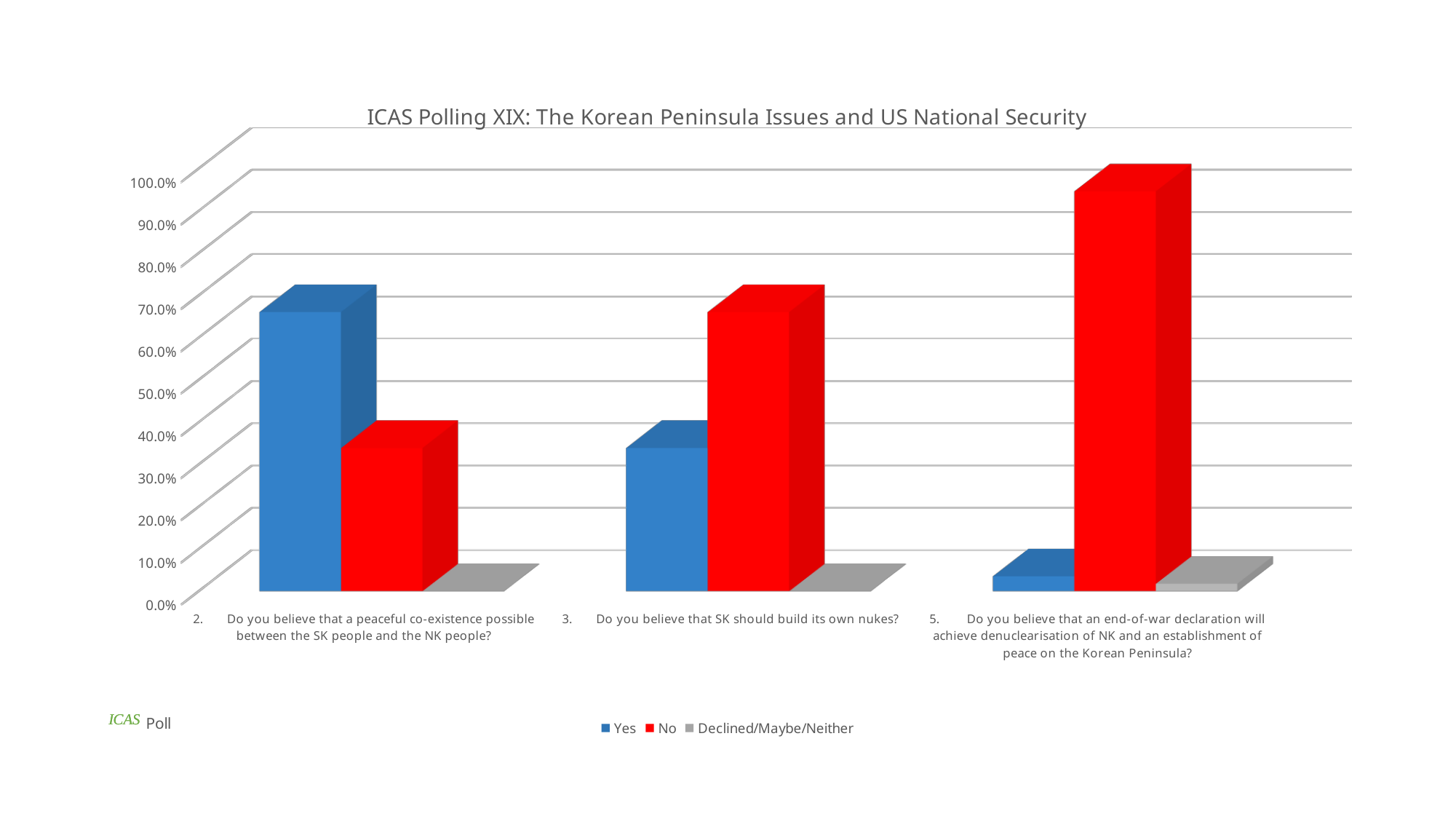
Is the 'Yes' value for question 5 (end-of-war declaration) greater or less than 10.0%? less For question 2 (peaceful co-existence), which is larger, the 'Yes' value or the 'No' value? Yes Which series is shown in red? No What kind of chart is shown on the slide? bar chart Is the 'No' value for question 5 (end-of-war declaration) greater or less than 80.0%? greater For question 3 (SK should build its own nukes), which is larger, the 'Yes' value or the 'No' value? No Is the 'Yes' value for question 3 (SK should build its own nukes) greater or less than 50.0%? less Which poll question has the highest 'No' value? 5. Do you believe that an end-of-war declaration will achieve denuclearisation of NK and an establishment of peace on the Korean Peninsula? What is the title of the chart? ICAS Polling XIX: The Korean Peninsula Issues and US National Security How many poll questions (categories) are plotted on the x axis? 3 How many series does the legend list? 3